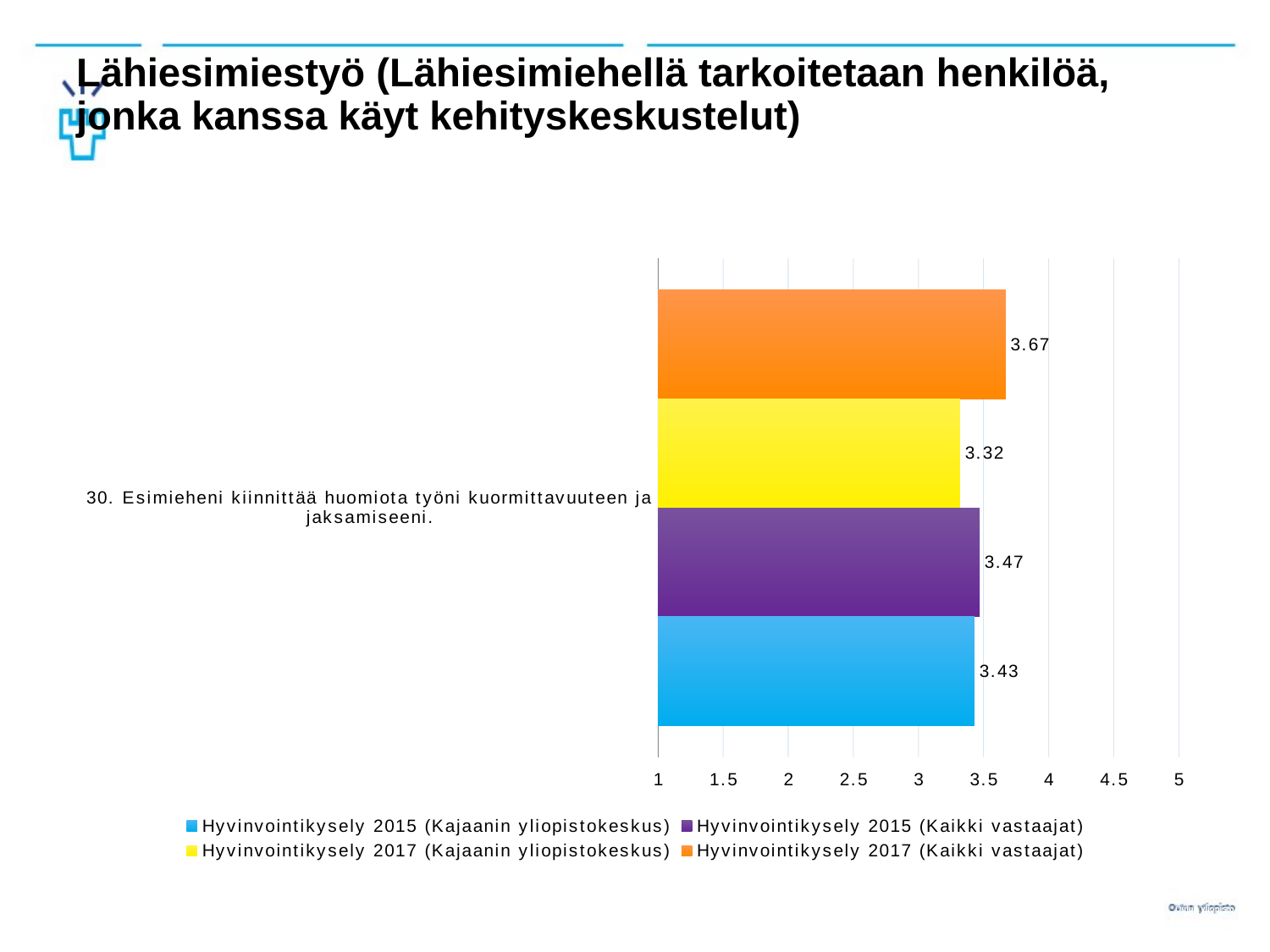
Which series has the lowest value on the chart? Hyvinvointikysely 2017 (Kajaanin yliopistokeskus) How many series does the legend list? 4 Is the value for Hyvinvointikysely 2017 (Kaikki vastaajat) greater or less than 3.5? greater What is the value for Hyvinvointikysely 2017 (Kaikki vastaajat) for item 30? 3.67 What is the value for Hyvinvointikysely 2017 (Kajaanin yliopistokeskus) for item 30? 3.32 What is the difference between the Hyvinvointikysely 2017 (Kaikki vastaajat) value and the Hyvinvointikysely 2017 (Kajaanin yliopistokeskus) value? 0.35 What is the value for Hyvinvointikysely 2015 (Kaikki vastaajat) for item 30? 3.47 Which is larger for item 30: the Hyvinvointikysely 2015 (Kajaanin yliopistokeskus) value or the Hyvinvointikysely 2017 (Kajaanin yliopistokeskus) value? Hyvinvointikysely 2015 (Kajaanin yliopistokeskus) What kind of chart is shown on the slide? Bar chart Which series has the highest value on the chart? Hyvinvointikysely 2017 (Kaikki vastaajat) What is the difference between the Hyvinvointikysely 2015 (Kaikki vastaajat) value and the Hyvinvointikysely 2015 (Kajaanin yliopistokeskus) value? 0.04 What is the value for Hyvinvointikysely 2015 (Kajaanin yliopistokeskus) for item 30? 3.43